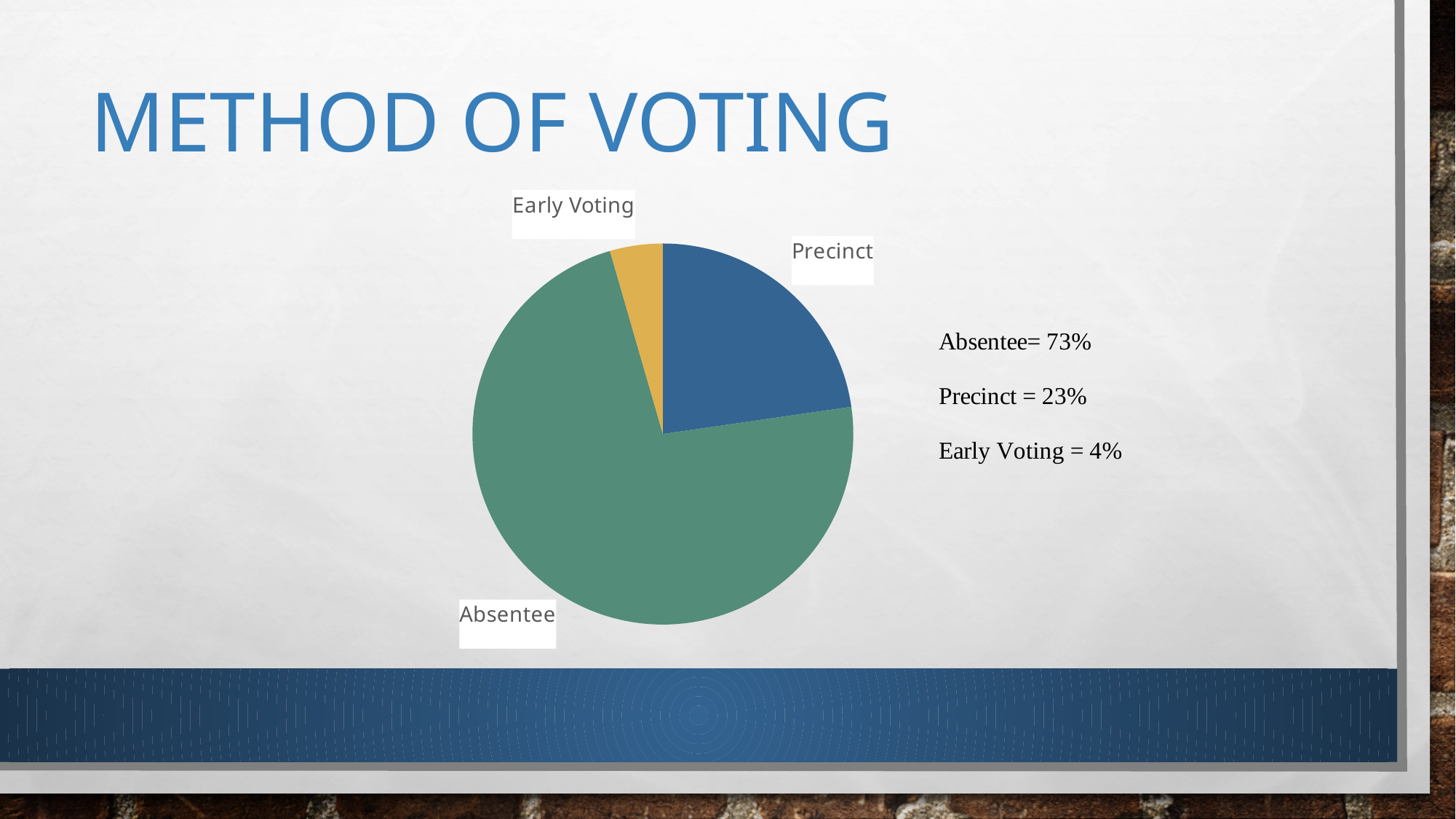
Which voting method has the smallest slice of the pie? Early Voting What colour is the Early Voting slice of the pie? yellow What share of the pie does Early Voting represent? 4% What is the difference in percentage points between Precinct and Early Voting? 19 What share of the pie does Absentee represent? 73% What kind of chart is shown on the slide? pie chart What is the difference in percentage points between Absentee and Precinct? 50 Which is larger, the Precinct slice or the Early Voting slice? Precinct What is the title of the slide containing the pie chart? Method of Voting What share of the pie does Precinct represent? 23% How many slices does the pie chart have? 3 Which voting method has the largest slice of the pie? Absentee